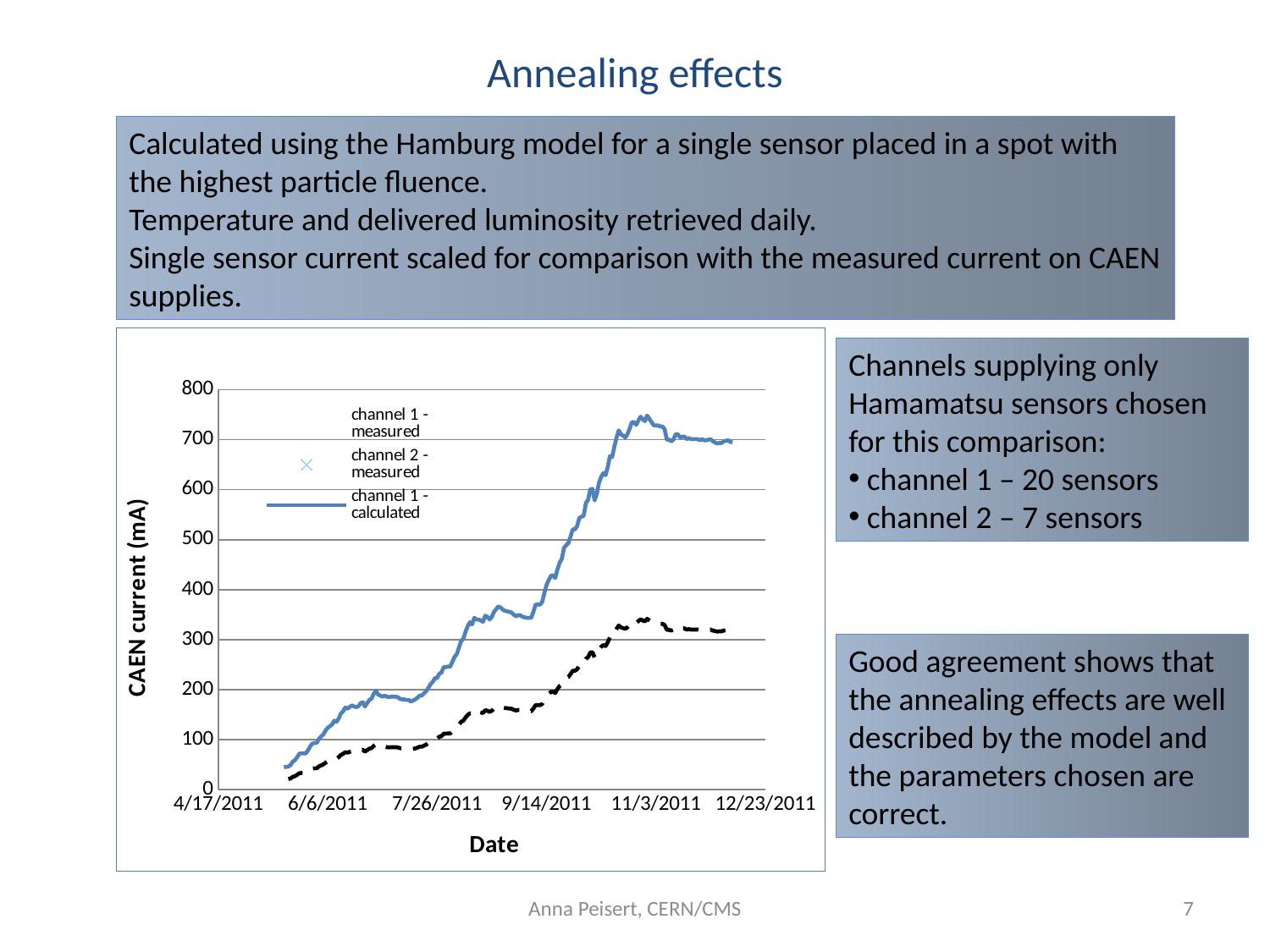
Around 11/3/2011, which is larger: the channel 1 - calculated line or the dashed black line? channel 1 - calculated How many date tick labels are shown on the horizontal axis? 6 What is the title of the horizontal axis of the chart? Date What is the title of the vertical axis of the chart? CAEN current (mA) Is the value of the channel 1 - calculated line at 6/6/2011 greater or less than 200? less Is the peak value of the channel 1 - calculated line greater or less than 700? greater How many series does the chart legend list? 3 Is the peak value of the dashed black line greater or less than 400? less What kind of chart is shown on the slide? line chart What is the highest value shown on the vertical axis of the chart? 800 Does the channel 1 - calculated line generally rise or fall from left to right across the chart? rise